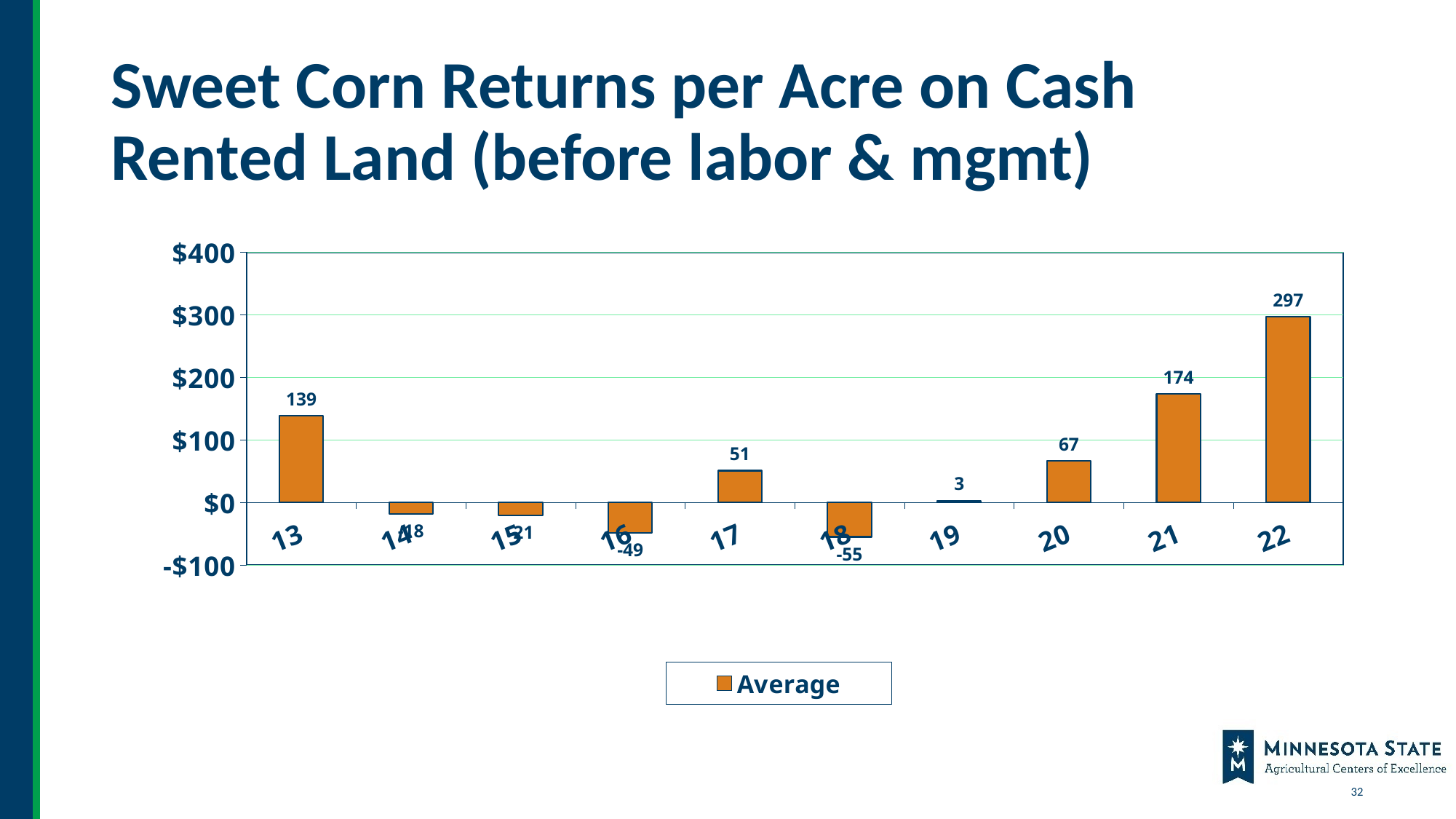
What is the value for 13? 139 What is the value for 16? -49 What is the value for 22? 297 What is the value for 19? 3 How many years are shown on the x axis? 10 Which is larger, the value for 17 or the value for 20? 20 Which year has the lowest value? 18 What series name does the legend show? Average What is the difference between the values for 22 and 21? 123 Is the value for 21 greater or less than $100? greater Which year has the highest value? 22 What type of chart is shown on the slide? bar chart